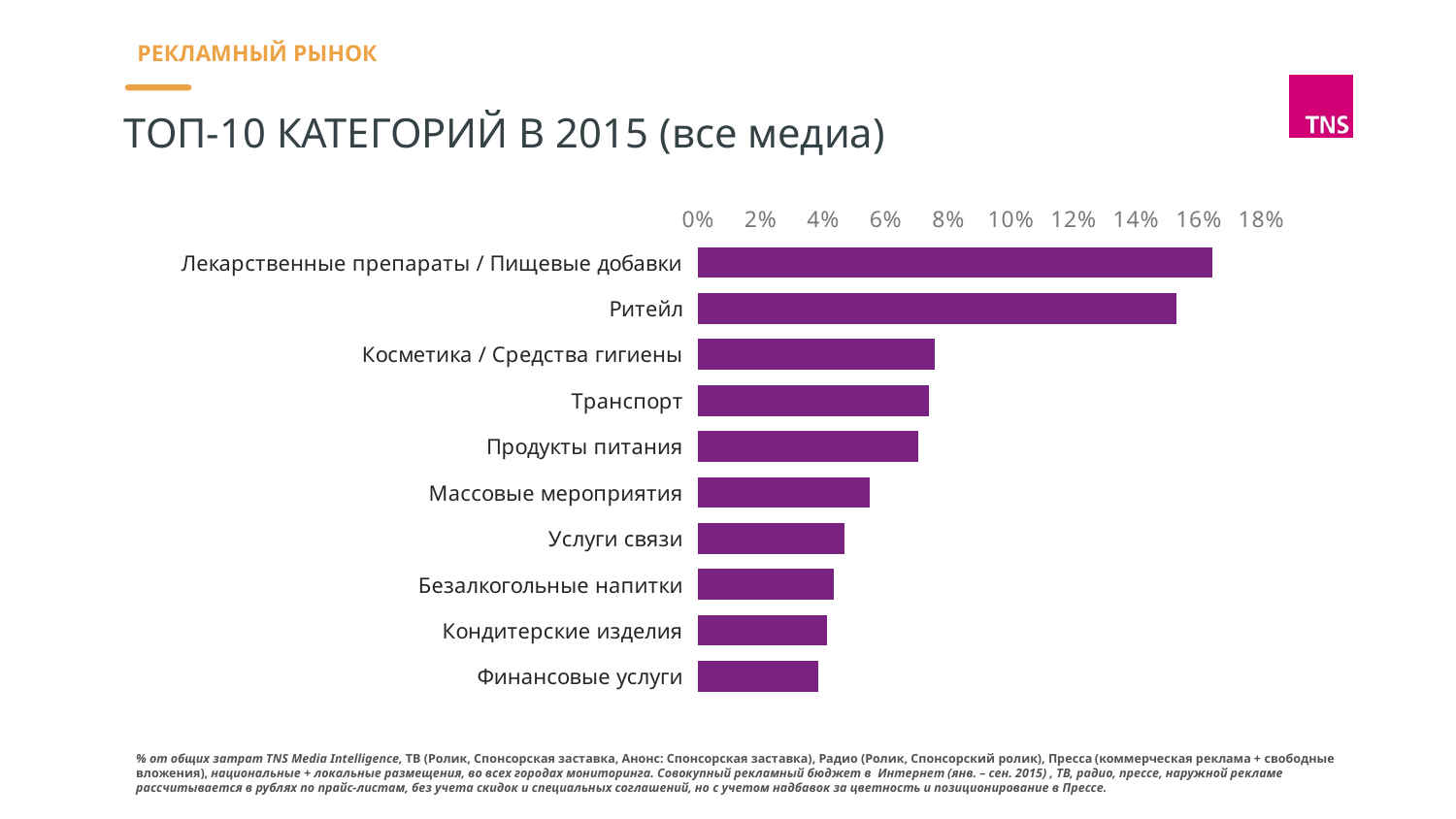
What kind of chart is shown on the slide? bar chart Is the value for Массовые мероприятия greater or less than 6%? less How many categories are shown in the chart? 10 Is the value for Транспорт greater or less than 6%? greater Which has a larger value, Ритейл or Косметика / Средства гигиены? Ритейл What is the title of the chart on the slide? ТОП-10 КАТЕГОРИЙ В 2015 (все медиа) Is the value for Финансовые услуги greater or less than 6%? less Which category has the lowest value in the chart? Финансовые услуги Which category has the highest value in the chart? Лекарственные препараты / Пищевые добавки